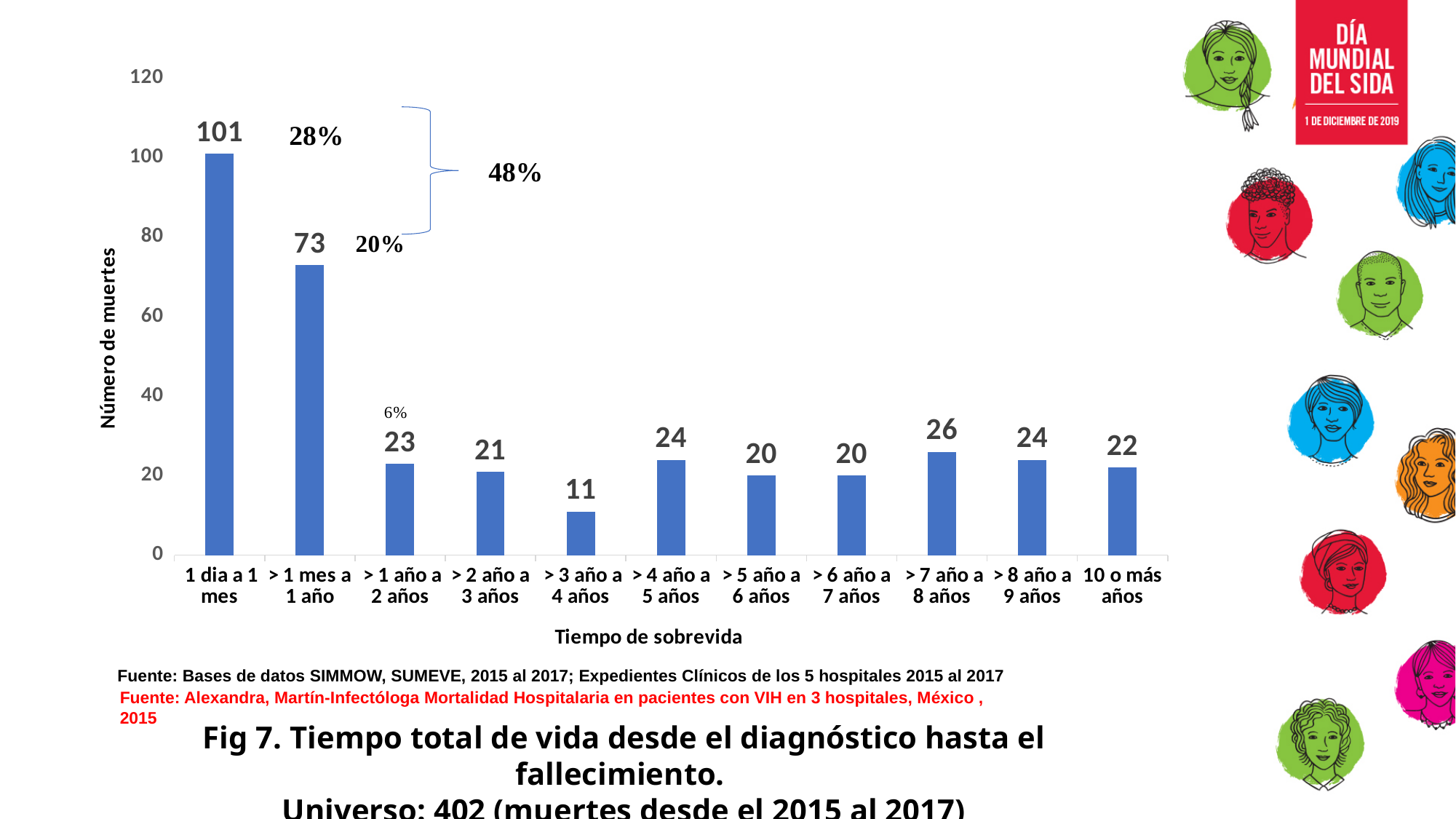
Which survival-time category has the highest number of deaths? 1 dia a 1 mes Which has more deaths: '> 7 año a 8 años' or '> 8 año a 9 años'? > 7 año a 8 años What is the difference in deaths between '1 dia a 1 mes' and '> 1 mes a 1 año'? 28 What is the label of the y axis? Número de muertes How many survival-time categories are shown on the x axis? 11 What is the number of deaths for the '1 dia a 1 mes' category? 101 What kind of chart is shown on the slide? Bar chart What is the number of deaths for the '> 1 mes a 1 año' category? 73 Is the value for '> 1 mes a 1 año' greater or less than 80? less Which survival-time category has the lowest number of deaths? > 3 año a 4 años What percentage is shown by the bracket combining the first two bars? 48% What is the number of deaths for the '> 3 año a 4 años' category? 11